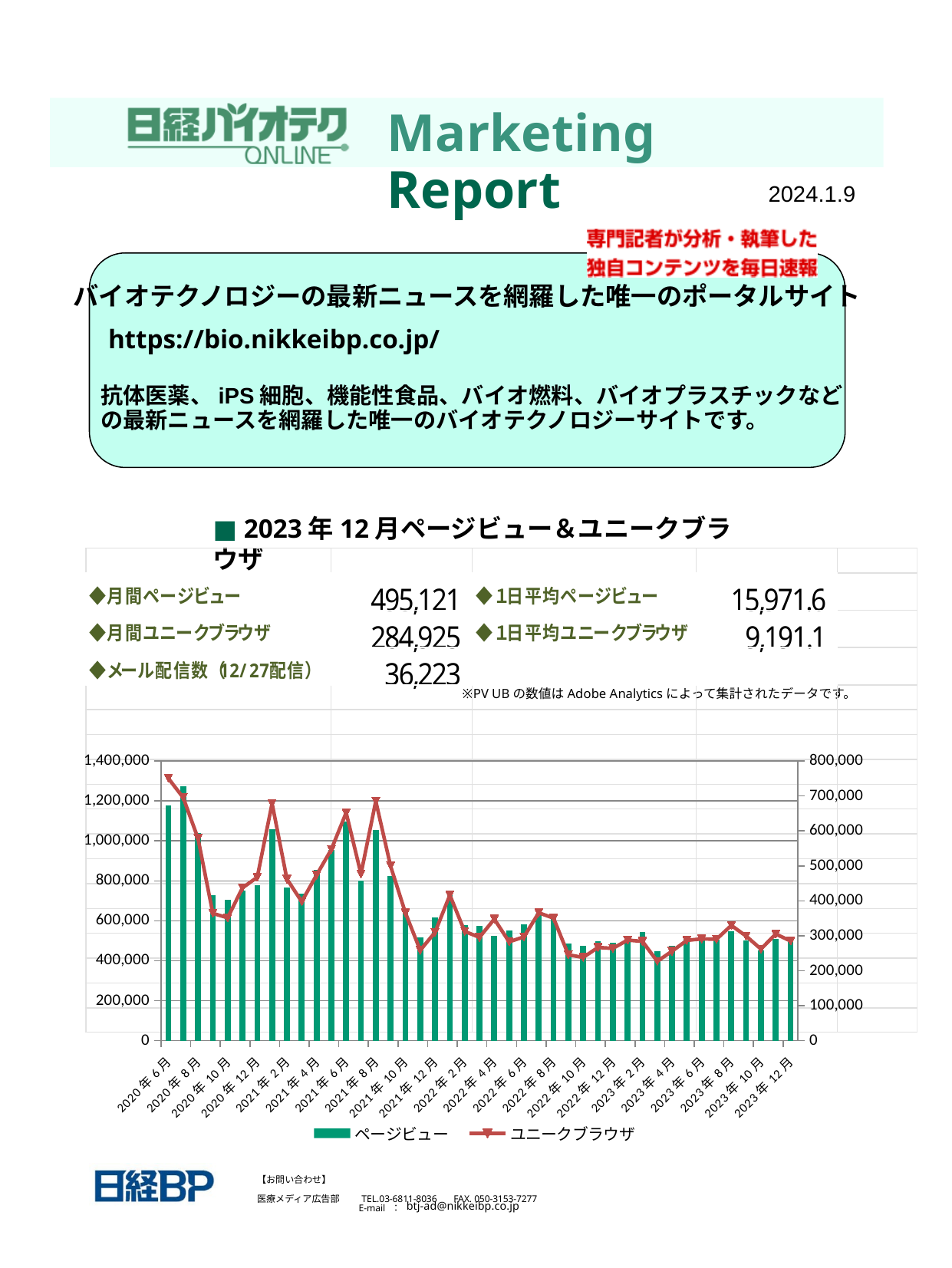
What kind of chart is shown on the slide? A combined bar and line chart What are the two series named in the chart legend? ページビュー and ユニークブラウザ Is the ユニークブラウザ value for 2020年6月 greater or less than 700,000? greater Is the ページビュー value for 2020年8月 greater or less than 1,200,000? less Is the ユニークブラウザ value for 2023年4月 greater or less than 300,000? less How many series does the chart legend list? 2 In which month does the ユニークブラウザ line reach its highest point? 2020年6月 Which series is drawn as bars in the chart? ページビュー Which has the higher ページビュー value, 2020年8月 or 2021年2月? 2020年8月 In which month is the ページビュー bar highest? 2020年7月 Overall, do the ページビュー values rise or fall from 2020年6月 to 2023年12月? fall